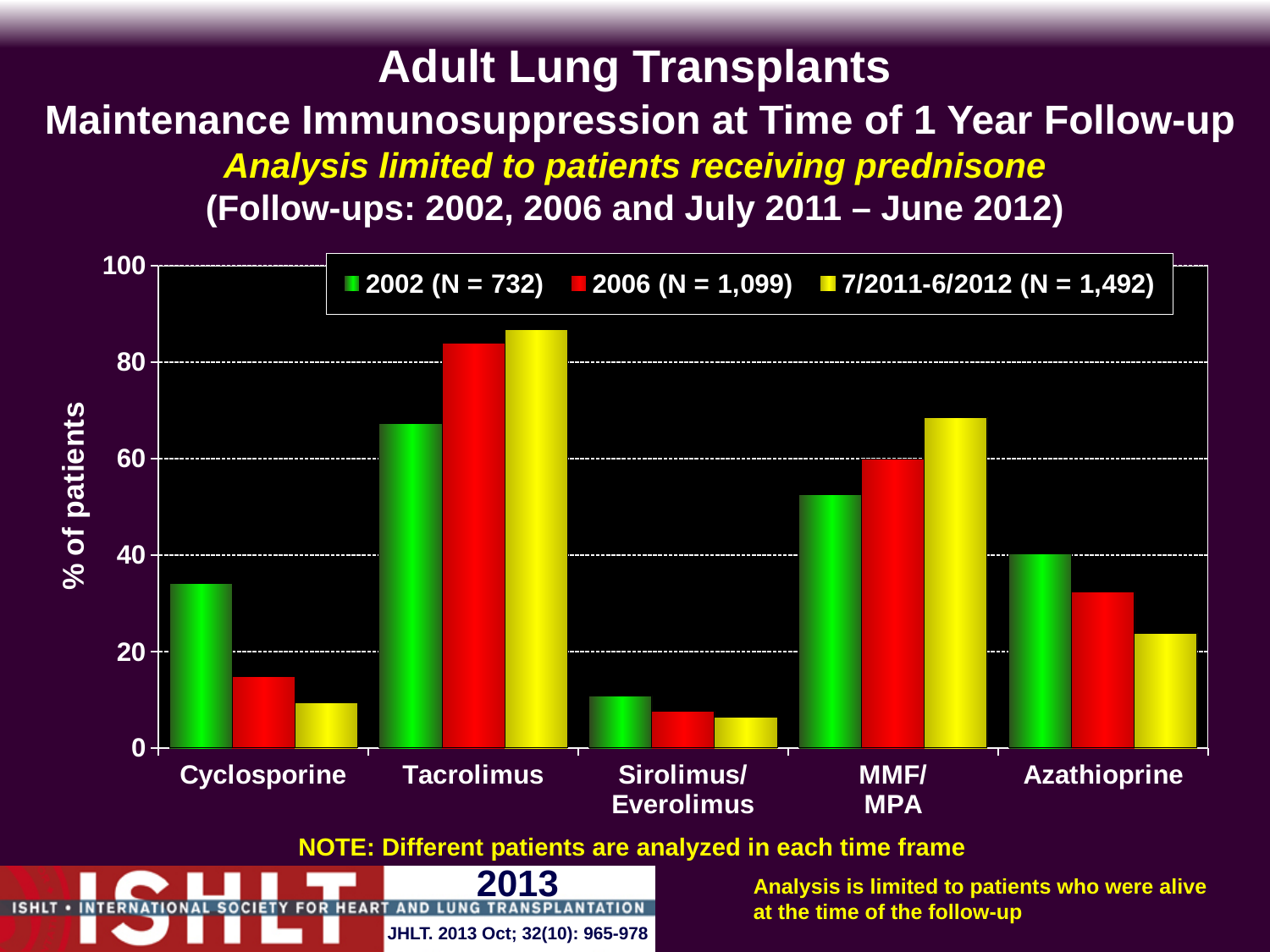
For Azathioprine, which is larger: the 2002 value or the 2006 value? 2002 Do the values for Cyclosporine rise or fall from 2002 to 7/2011-6/2012? fall Do the values for Tacrolimus rise or fall from 2002 to 7/2011-6/2012? rise Which drug category has the highest value for the 7/2011-6/2012 series? Tacrolimus What kind of chart is shown on the slide? bar chart How many drug categories are shown on the x axis? 5 Is the value for MMF/MPA in 7/2011-6/2012 greater or less than 60? greater According to the legend, what is the N for the 2006 series? 1,099 Is the value for Tacrolimus in 2006 greater or less than 80? greater Is the value for Cyclosporine in 2002 greater or less than 40? less Which drug category has the lowest value for the 2002 series? Sirolimus/Everolimus How many series does the legend list? 3